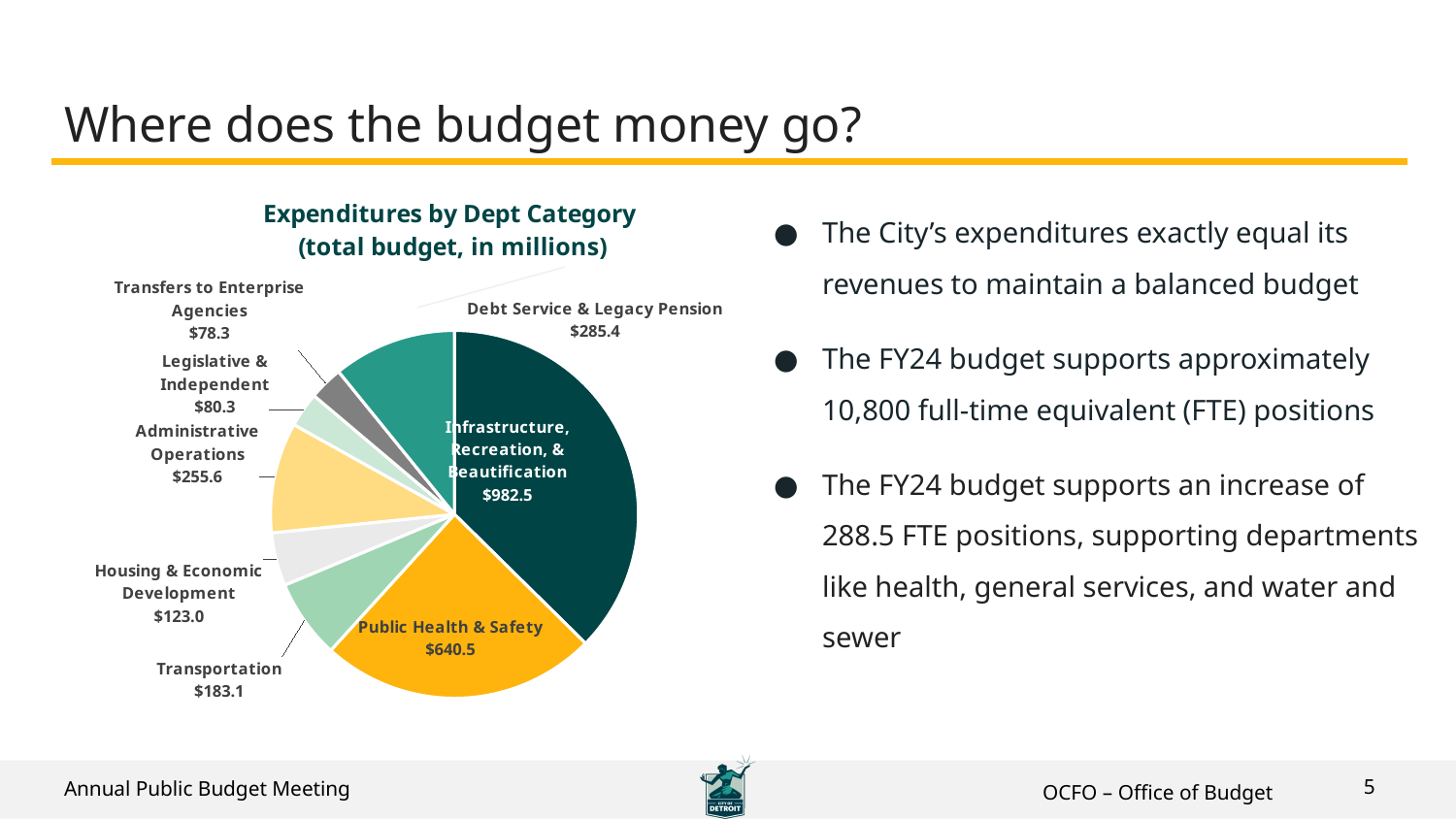
Which is larger, Debt Service & Legacy Pension or Administrative Operations? Debt Service & Legacy Pension What is the title of the chart? Expenditures by Dept Category (total budget, in millions) What is the value for Infrastructure, Recreation, & Beautification? $982.5 What is the value for Public Health & Safety? $640.5 What is the value for Debt Service & Legacy Pension? $285.4 How many categories are shown in the pie chart? 8 Which category has the smallest expenditure? Transfers to Enterprise Agencies What is the difference between Infrastructure, Recreation, & Beautification and Public Health & Safety? $342.0 What type of chart is shown on the slide? Pie chart What is the value for Transfers to Enterprise Agencies? $78.3 What is the difference between Transportation and Housing & Economic Development? $60.1 Which category has the largest expenditure? Infrastructure, Recreation, & Beautification